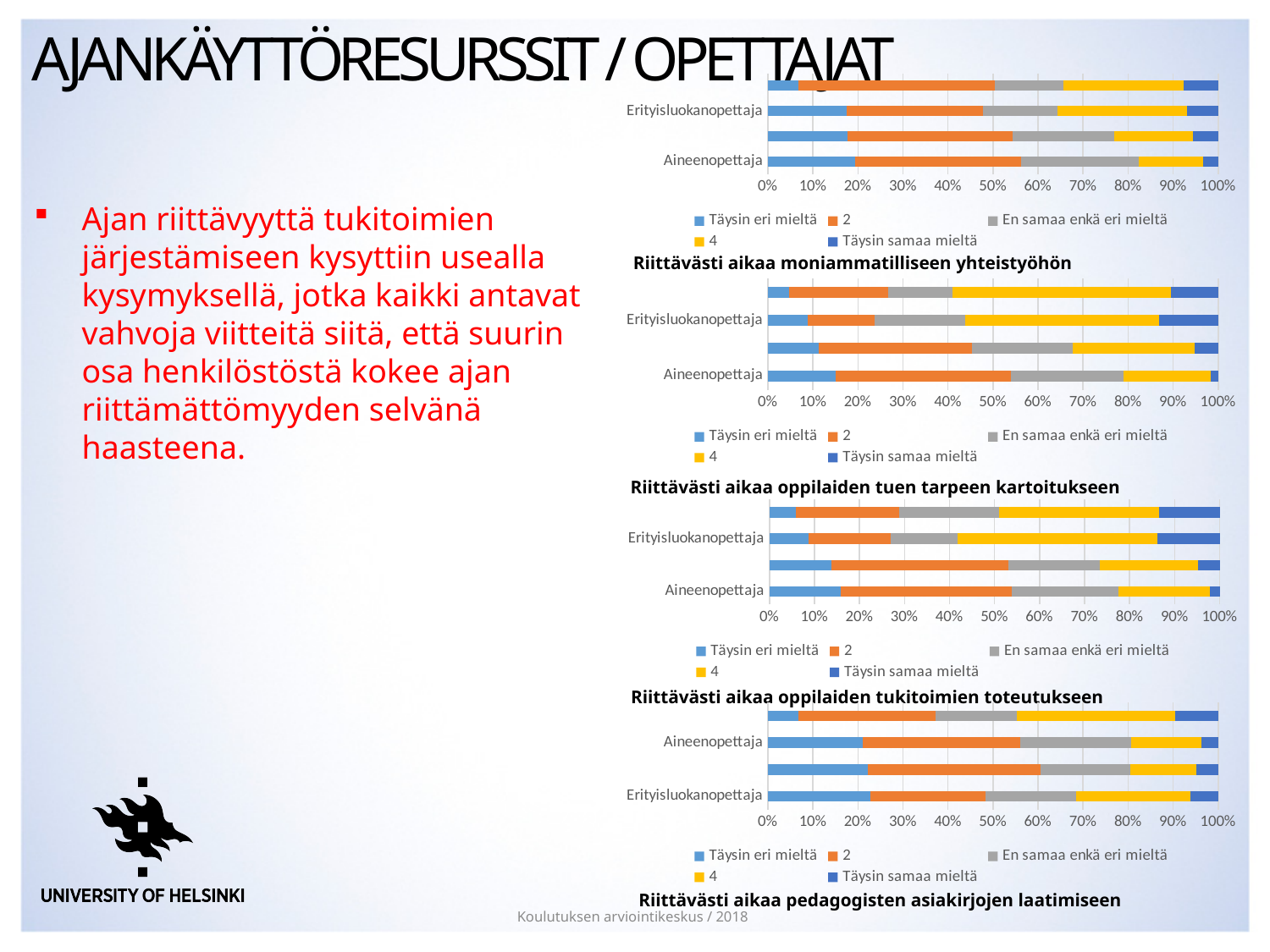
How many series does the legend list in the chart titled 'Riittävästi aikaa oppilaiden tuen tarpeen kartoitukseen'? 5 What kind of chart is the chart titled 'Riittävästi aikaa moniammatilliseen yhteistyöhön'? Stacked bar chart In the chart titled 'Riittävästi aikaa oppilaiden tuen tarpeen kartoitukseen', is the 'Täysin samaa mieltä' share for Erityisluokanopettaja greater or less than 10%? greater In the chart titled 'Riittävästi aikaa oppilaiden tukitoimien toteutukseen', what is the highest value shown on the x axis? 100% In the chart titled 'Riittävästi aikaa oppilaiden tukitoimien toteutukseen', is the 'Täysin samaa mieltä' share for Aineenopettaja greater or less than 10%? less In the chart titled 'Riittävästi aikaa oppilaiden tuen tarpeen kartoitukseen', which has the larger 'Täysin eri mieltä' share, Aineenopettaja or Erityisluokanopettaja? Aineenopettaja In the chart titled 'Riittävästi aikaa pedagogisten asiakirjojen laatimiseen', is the 'Täysin eri mieltä' share for Aineenopettaja greater or less than 10%? greater In the chart titled 'Riittävästi aikaa pedagogisten asiakirjojen laatimiseen', what is the first legend entry? Täysin eri mieltä In the chart titled 'Riittävästi aikaa moniammatilliseen yhteistyöhön', which has the larger 'Täysin samaa mieltä' share, Erityisluokanopettaja or Aineenopettaja? Erityisluokanopettaja How many charts are shown on the slide? 4